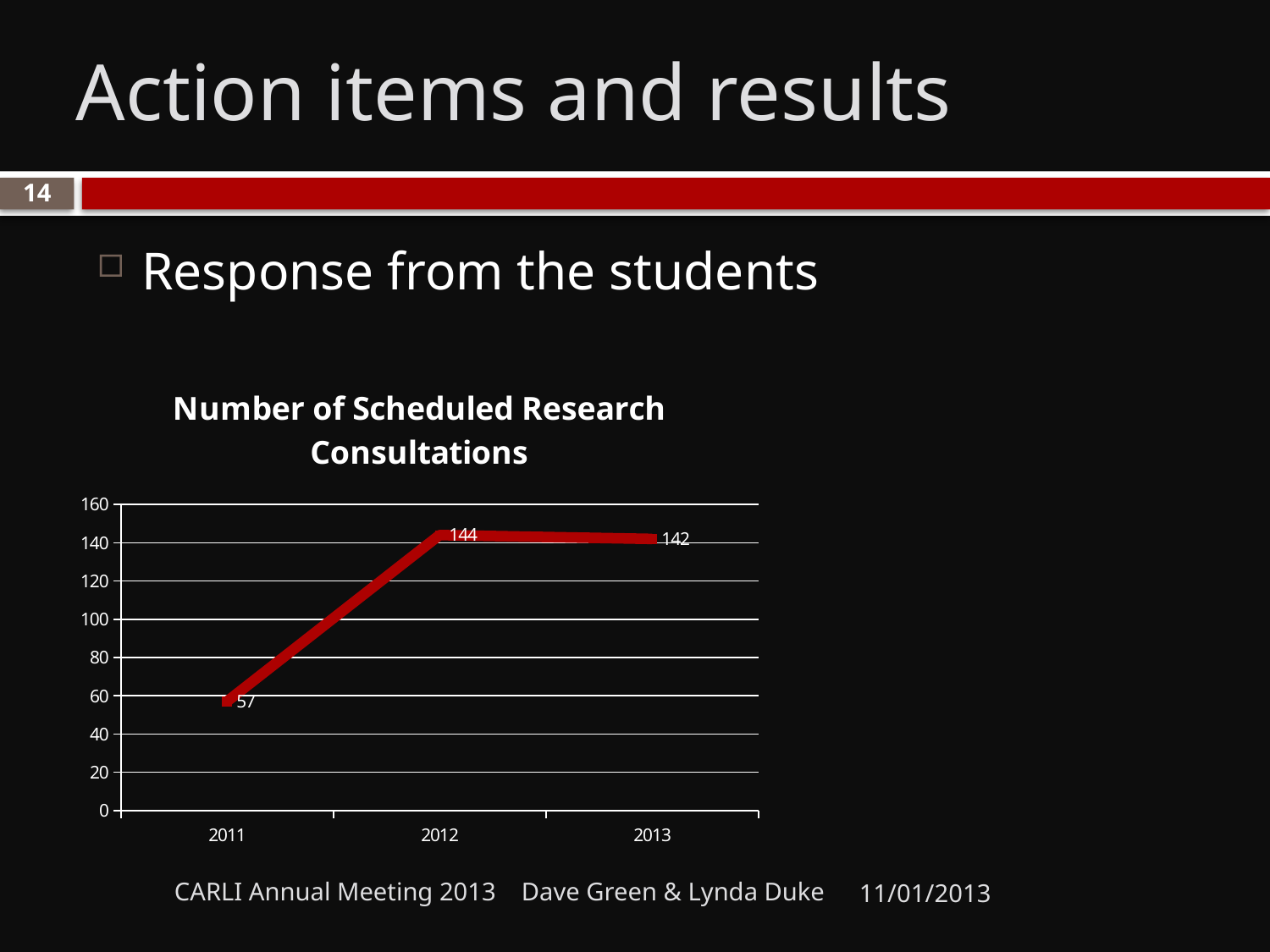
What is the number of scheduled research consultations in 2011? 57 What kind of chart is shown on the slide? line chart What is the number of scheduled research consultations in 2013? 142 Which year had more scheduled research consultations, 2011 or 2013? 2013 What is the number of scheduled research consultations in 2012? 144 What is the difference between the number of consultations in 2012 and 2013? 2 Which year has the highest number of scheduled research consultations? 2012 Which year has the lowest number of scheduled research consultations? 2011 How many years are plotted on the chart? 3 Is the value for 2011 greater or less than 60? less What is the difference between the number of consultations in 2012 and 2011? 87 What is the title of the chart? Number of Scheduled Research Consultations